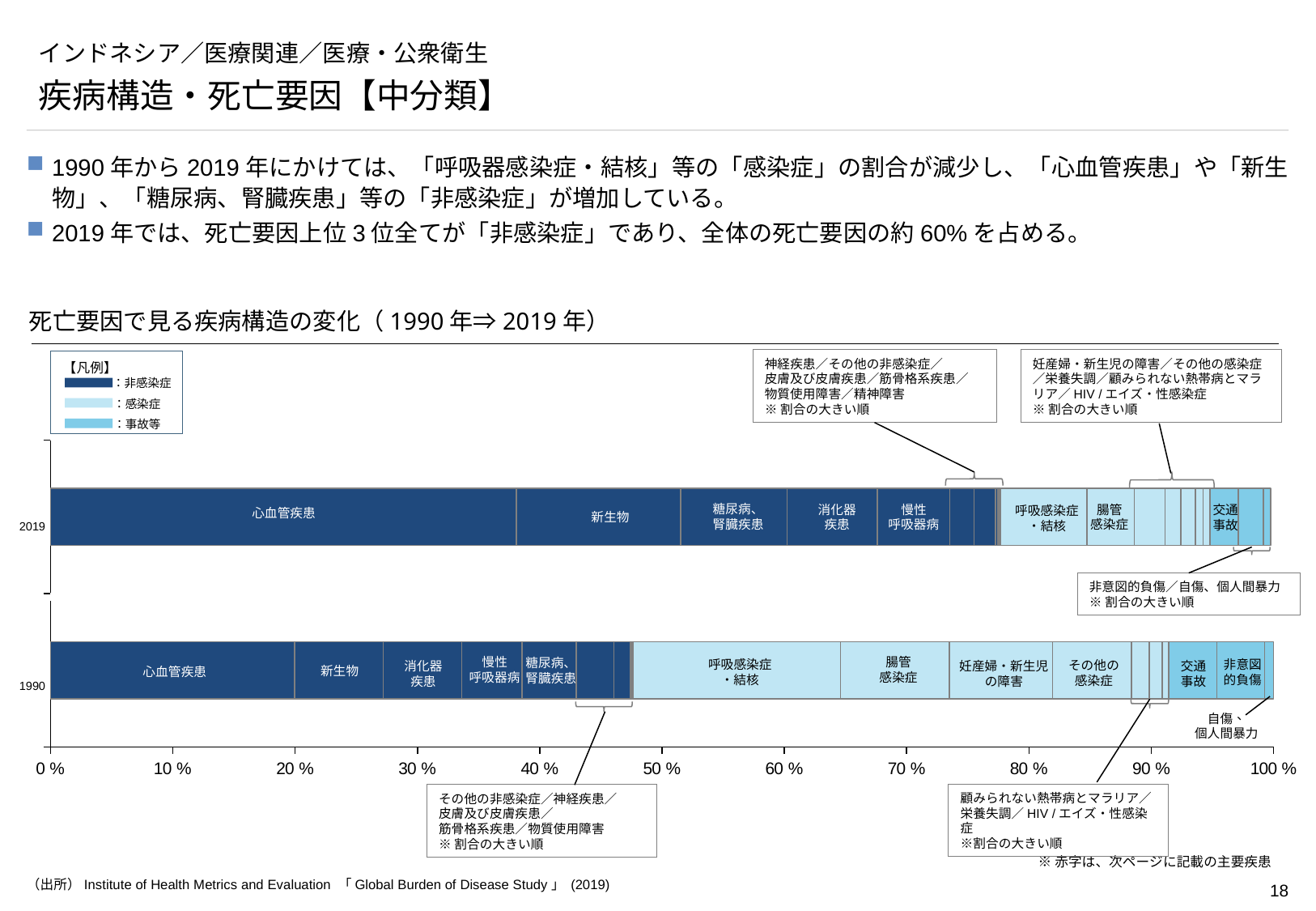
Which years are shown as the two bars in the chart? 1990 and 2019 Is the share of 呼吸感染症・結核 in 1990 greater or less than 10%? greater Is the share of 心血管疾患 in 2019 greater or less than 30%? greater Which year has the larger share of 心血管疾患, 1990 or 2019? 2019 How many bars (years) are plotted in the chart? 2 In the 1990 bar, which cause of death has the largest share? 心血管疾患 What kind of chart is shown on the slide? Stacked bar chart Is the share of 心血管疾患 in 1990 greater or less than 30%? less Which legend category is shown in the darkest blue colour? 非感染症 In the 2019 bar, which is larger: the share of 心血管疾患 or the share of 新生物? 心血管疾患 How many categories does the legend (凡例) list? 3 In the 2019 bar, which cause of death has the largest share? 心血管疾患